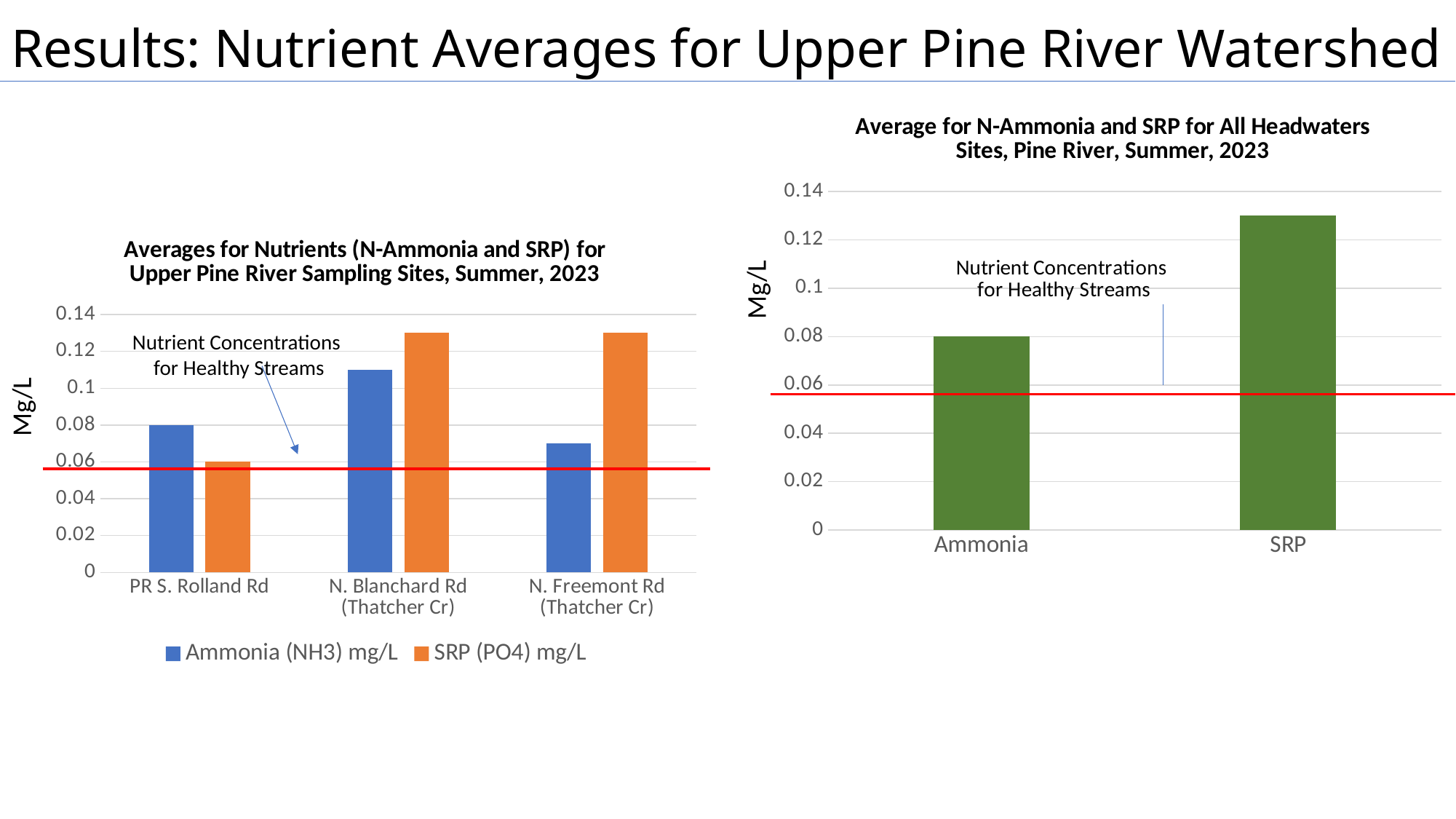
In the right chart, what is the value for Ammonia? 0.08 In the left chart, is the SRP (PO4) mg/L value for N. Blanchard Rd (Thatcher Cr) greater or less than 0.12? greater How many series does the legend of the left chart list? 2 What type of chart is the right chart? Bar chart In the left chart, which site has the lowest SRP (PO4) mg/L value? PR S. Rolland Rd In the left chart, which site has the highest Ammonia (NH3) mg/L value? N. Blanchard Rd (Thatcher Cr) In the left chart, what is the Ammonia (NH3) mg/L value for PR S. Rolland Rd? 0.08 In the left chart, what is the SRP (PO4) mg/L value for PR S. Rolland Rd? 0.06 In the right chart, which is larger, Ammonia or SRP? SRP In the right chart, is the value for SRP greater or less than 0.12? greater In the left chart, what is the difference between the Ammonia (NH3) mg/L and SRP (PO4) mg/L values for PR S. Rolland Rd? 0.02 In the left chart, is the Ammonia (NH3) mg/L value for N. Freemont Rd (Thatcher Cr) greater or less than 0.08? less